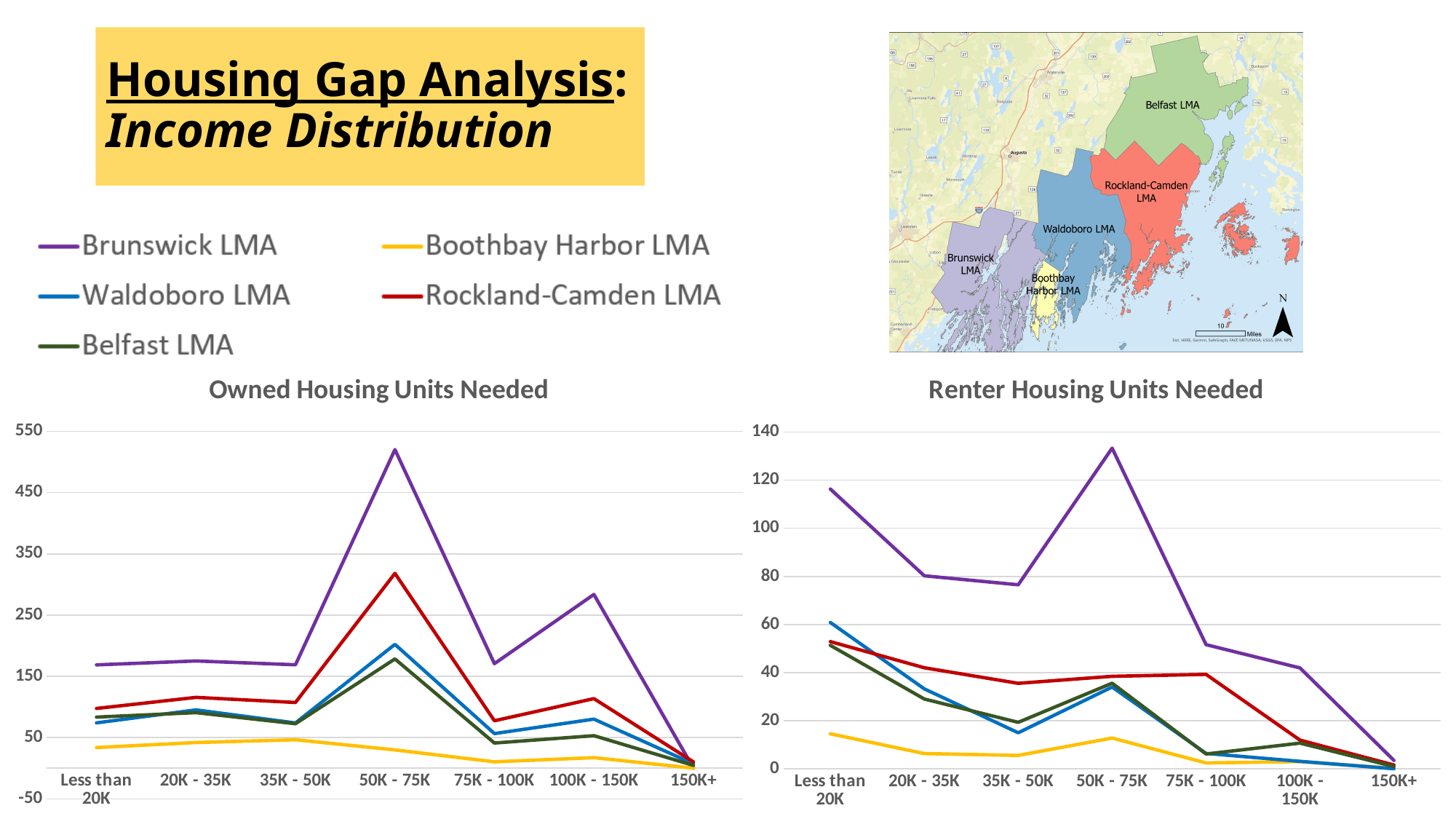
In the "Renter Housing Units Needed" chart, is the Boothbay Harbor LMA value for Less than 20K greater or less than 20? less In the "Renter Housing Units Needed" chart, which income category has the highest Brunswick LMA value? 50K - 75K In the "Renter Housing Units Needed" chart, does the Brunswick LMA line rise or fall from 100K - 150K to 150K+? Fall What kind of chart is the "Owned Housing Units Needed" chart? Line chart In the "Owned Housing Units Needed" chart, which series has the lowest value in the 50K - 75K category? Boothbay Harbor LMA How many series does the legend list for the charts? 5 In the "Renter Housing Units Needed" chart, is the Brunswick LMA value for Less than 20K greater or less than 100? greater In the "Owned Housing Units Needed" chart, is the Rockland-Camden LMA value for 50K - 75K greater or less than 350? less What colour is the Brunswick LMA line in the legend? Purple In the "Owned Housing Units Needed" chart, which series has the highest value in the 50K - 75K category? Brunswick LMA How many income categories are shown on the x axis of the "Renter Housing Units Needed" chart? 7